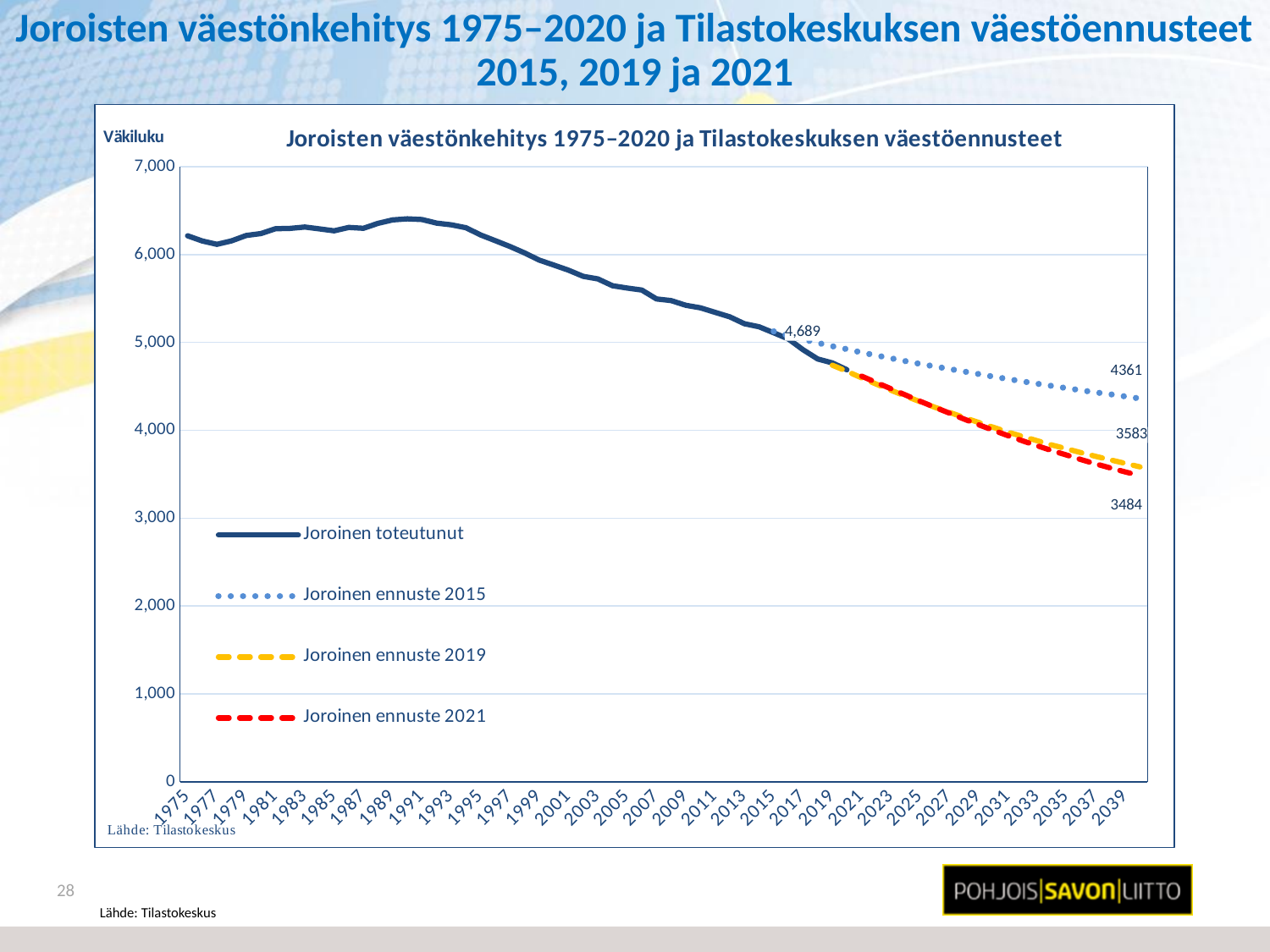
Which series ends higher, Joroinen ennuste 2015 or Joroinen ennuste 2021? Joroinen ennuste 2015 What label is shown on the vertical axis of the chart? Väkiluku Which forecast series ends at the lowest labelled value? Joroinen ennuste 2021 Does the Joroinen toteutunut series rise or fall between 1995 and 2020? fall What is the difference between the final labelled values of the Joroinen ennuste 2015 series (4361) and the Joroinen ennuste 2021 series (3484)? 877 What is the final labelled value of the Joroinen ennuste 2021 series? 3484 How many series does the chart legend list? 4 Is the value of the Joroinen toteutunut series in 1975 greater or less than 6,000? greater What is the final labelled value of the Joroinen ennuste 2015 series? 4361 What is the final labelled value of the Joroinen ennuste 2019 series? 3583 What type of chart is shown on the slide? line chart